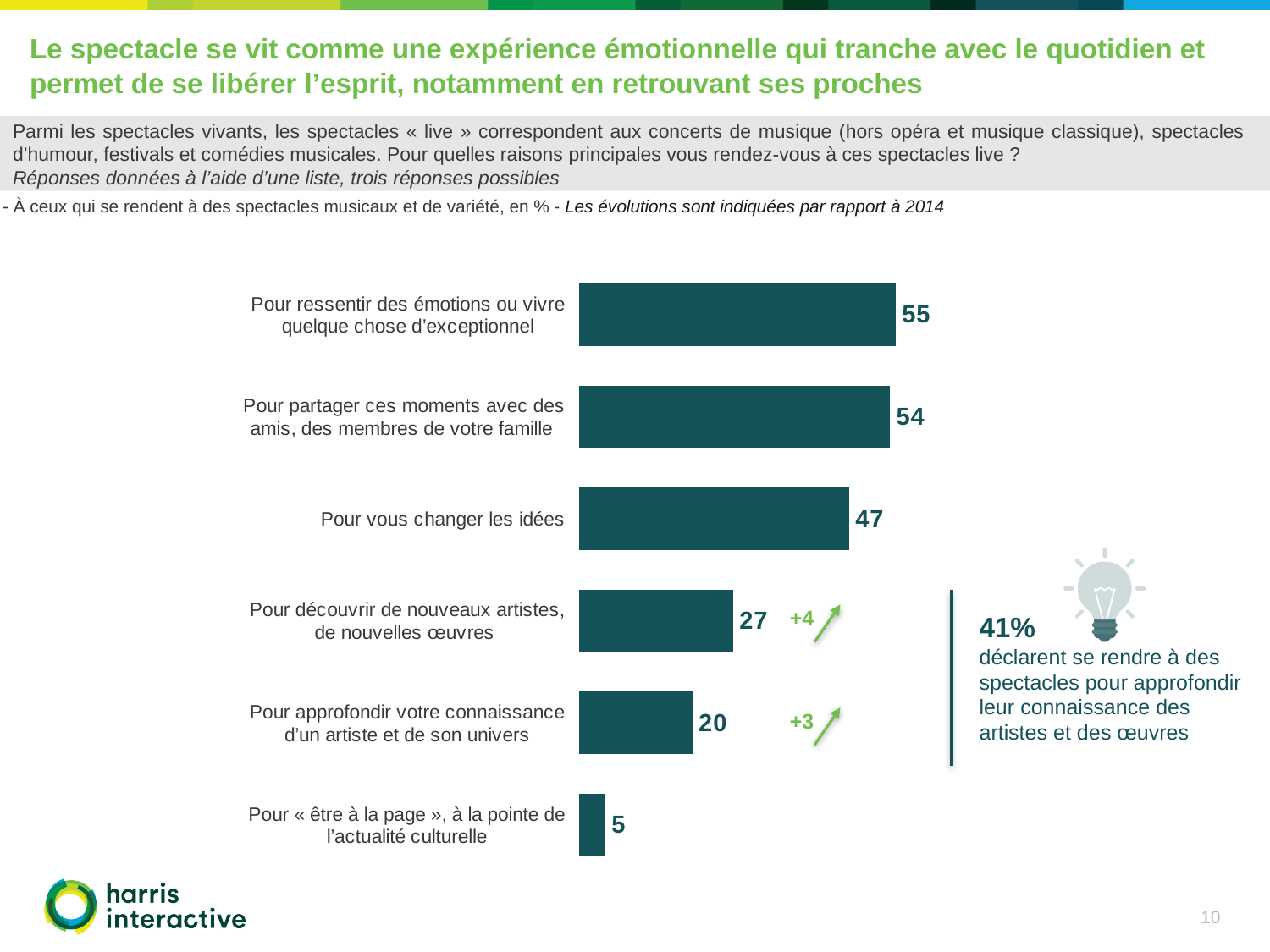
Which is larger: the value for "Pour partager ces moments avec des amis, des membres de votre famille" or the value for "Pour vous changer les idées"? Pour partager ces moments avec des amis, des membres de votre famille What is the difference between the values for "Pour vous changer les idées" and "Pour découvrir de nouveaux artistes, de nouvelles œuvres"? 20 What percentage is highlighted in the callout to the right of the chart? 41% What change since 2014 is indicated next to "Pour découvrir de nouveaux artistes, de nouvelles œuvres"? +4 What change since 2014 is indicated next to "Pour approfondir votre connaissance d'un artiste et de son univers"? +3 What is the value for "Pour approfondir votre connaissance d'un artiste et de son univers"? 20 What is the value for "Pour ressentir des émotions ou vivre quelque chose d'exceptionnel"? 55 Which category has the highest value? Pour ressentir des émotions ou vivre quelque chose d'exceptionnel Which category has the lowest value? Pour « être à la page », à la pointe de l'actualité culturelle How many categories are shown in the chart? 6 What kind of chart is shown on the slide? Bar chart What is the value for "Pour vous changer les idées"? 47